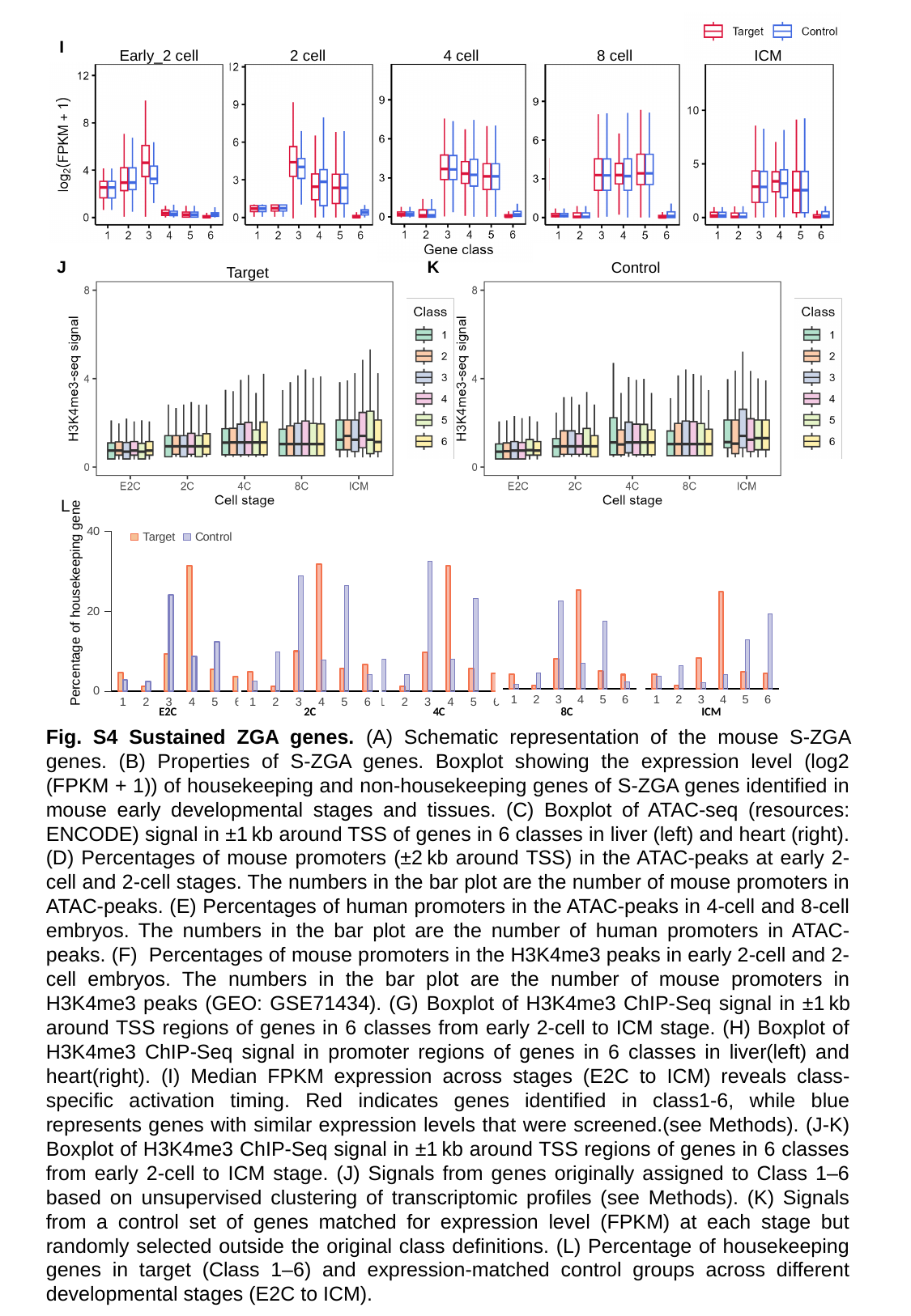
In panel L, which class has the highest Target bar at the E2C stage? 4 What kind of chart is panel L (Percentage of housekeeping gene)? bar chart How many series does the legend of panel L list? 2 In panel L, is the Control value for class 3 at the 4C stage greater or less than 20? greater In panel L, is the Target value for class 4 at the E2C stage greater or less than 20? greater In panel L, is the Target value for class 1 at the E2C stage greater or less than 20? less In panel L, at the 4C stage for class 3, which is larger, the Target bar or the Control bar? Control In panel L, at the E2C stage for class 4, which is larger, the Target bar or the Control bar? Target In panel I, which colour represents the Target genes? red How many cell stages are shown on the x axis of panel J (Target)? 5 How many gene classes are shown on the x axis of each boxplot in panel I? 6 How many classes does the legend of panel J (Target) list? 6